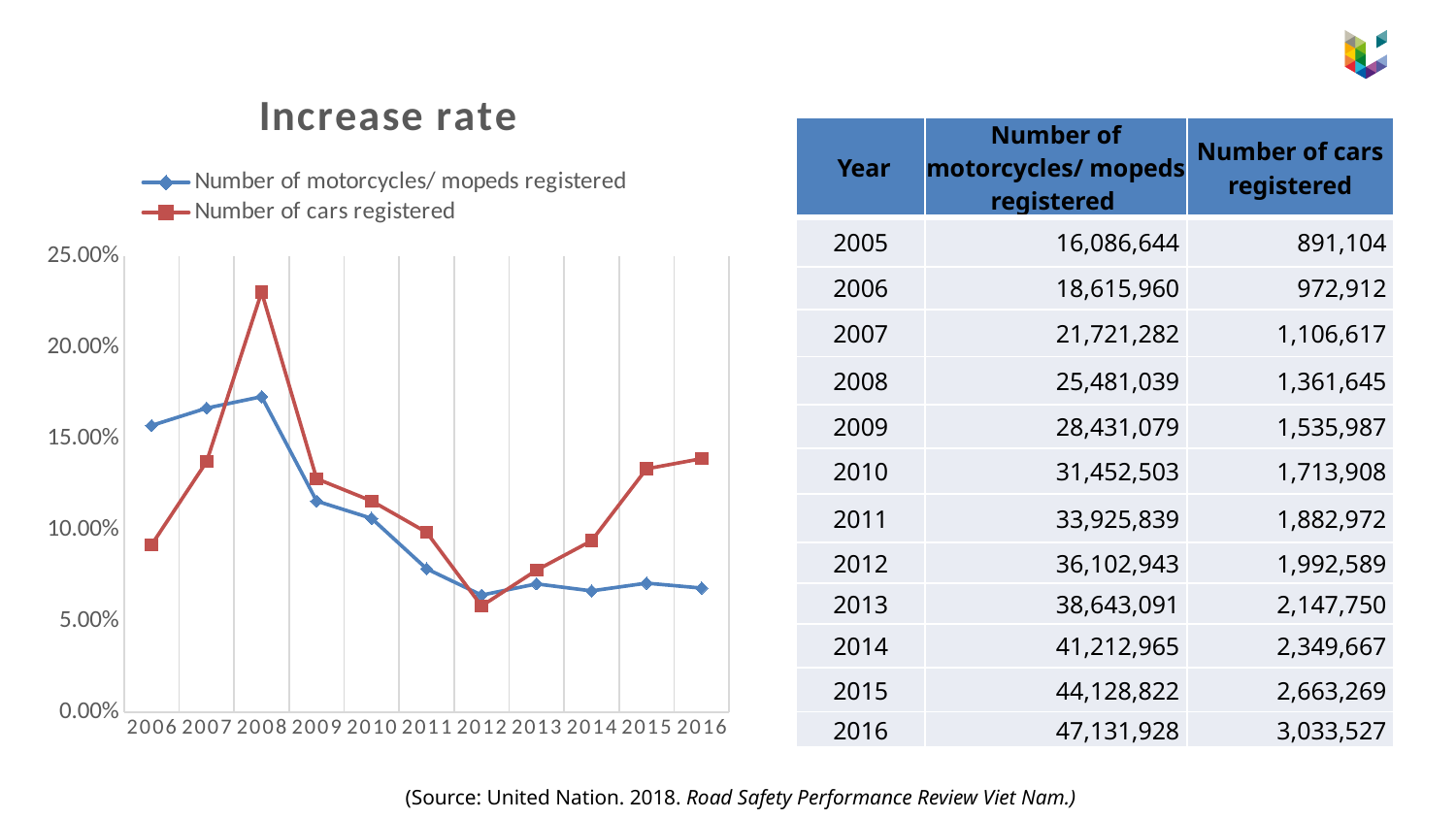
Is the value for 'Number of cars registered' in 2008 greater or less than 20.00%? greater Does the 'Number of motorcycles/ mopeds registered' series rise or fall from 2008 to 2012? Fall In which year does the 'Number of cars registered' series reach its highest value? 2008 Which series is drawn with red square markers? Number of cars registered In 2016, which series has the larger value: 'Number of cars registered' or 'Number of motorcycles/ mopeds registered'? Number of cars registered What is the title of the chart? Increase rate What kind of chart is shown on the slide? Line chart In which year does the 'Number of motorcycles/ mopeds registered' series reach its highest value? 2008 How many years are plotted along the x axis of the chart? 11 Is the value for 'Number of motorcycles/ mopeds registered' in 2016 greater or less than 10.00%? less In which year does the 'Number of cars registered' series reach its lowest value? 2012 How many series does the chart's legend list? 2